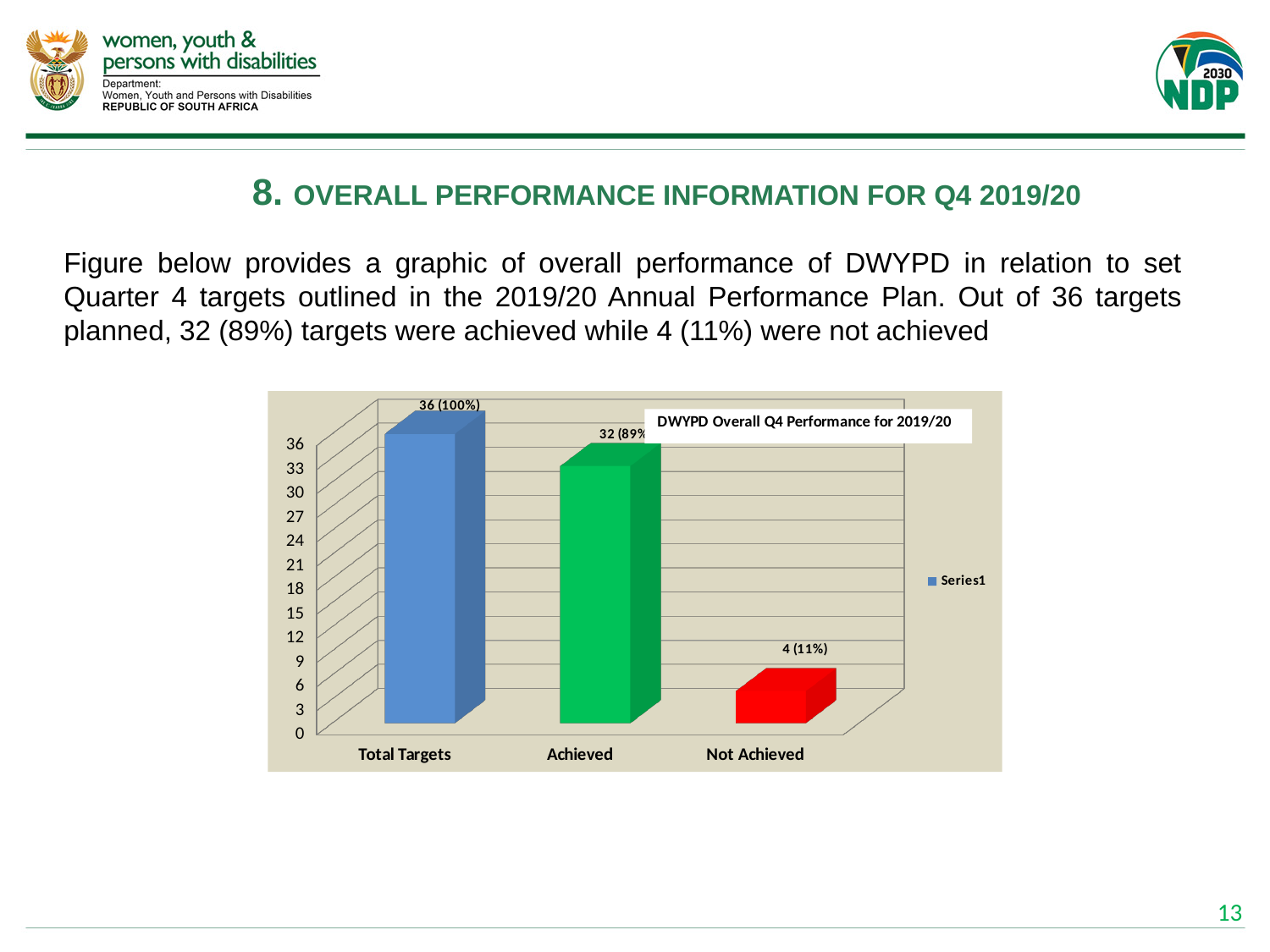
How many categories are shown on the x axis? 3 Which category has the lowest value? Not Achieved Which is larger, the value for Achieved or the value for Not Achieved? Achieved What is the data label shown for Not Achieved? 4 (11%) Is the value for Not Achieved greater or less than 9? less Which category has the highest value? Total Targets What is the data label shown for Total Targets? 36 (100%) What kind of chart is shown on the slide? bar chart What is the difference between the Total Targets value and the Achieved value? 4 What is the difference between the Achieved value and the Not Achieved value? 28 What is the title of the chart? DWYPD Overall Q4 Performance for 2019/20 How many targets were achieved according to the chart? 32